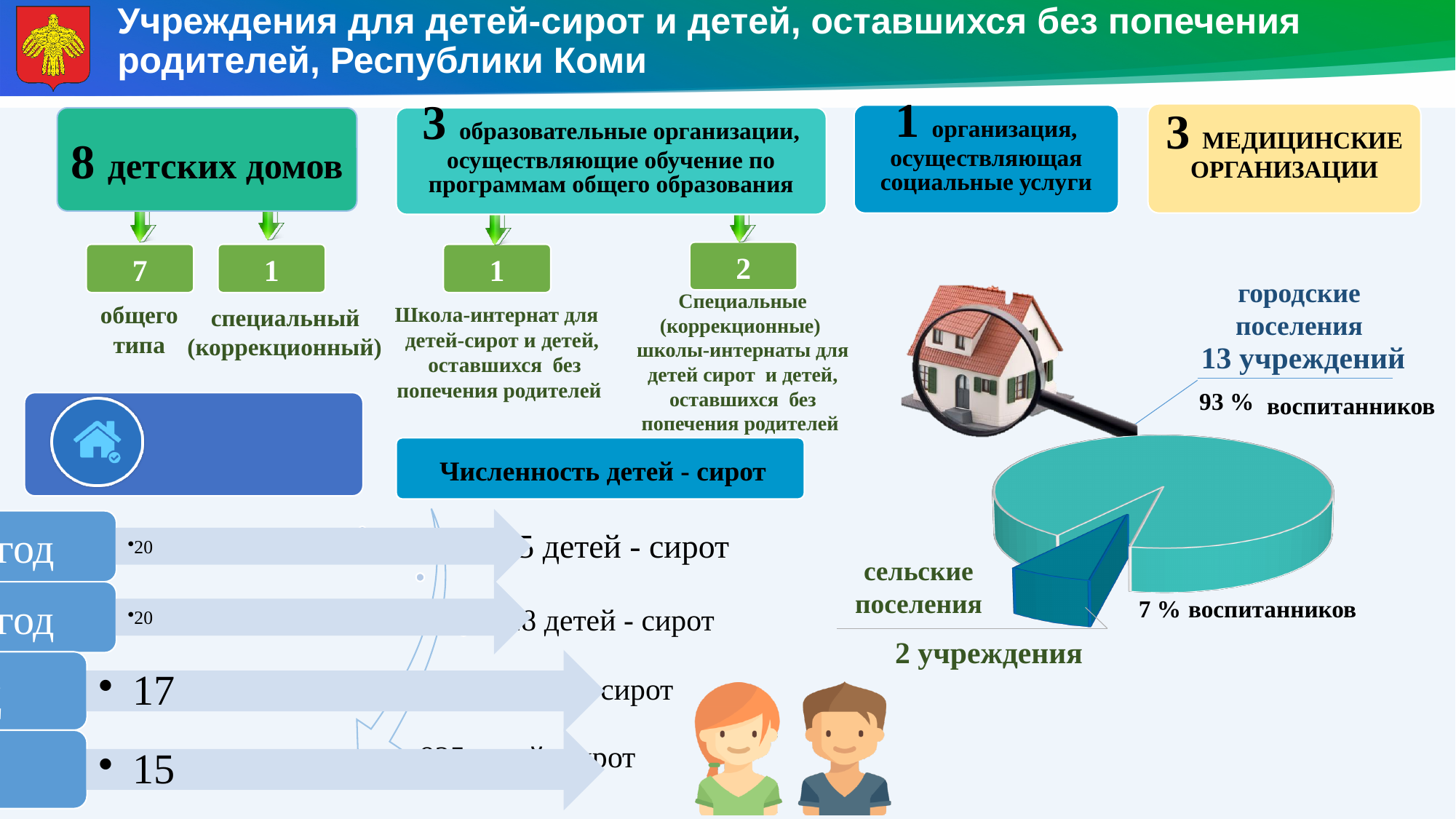
In the pie chart, what share of воспитанников is in сельские поселения? 7 % What kind of chart is shown on the right side of the slide? pie chart Which slice of the pie chart is the smallest? сельские поселения In the pie chart, which has a larger share of воспитанников: городские поселения or сельские поселения? городские поселения According to the pie chart labels, how many учреждения are in сельские поселения? 2 учреждения Which slice of the pie chart is the largest? городские поселения What colour is the larger slice (городские поселения) in the pie chart? teal In the pie chart, by how many percentage points does the share for городские поселения exceed the share for сельские поселения? 86 According to the pie chart labels, how many учреждений are in городские поселения? 13 учреждений Is the share for сельские поселения in the pie chart greater or less than 10%? less In the pie chart, what share of воспитанников is in городские поселения? 93 % How many slices does the pie chart on the right have? 2